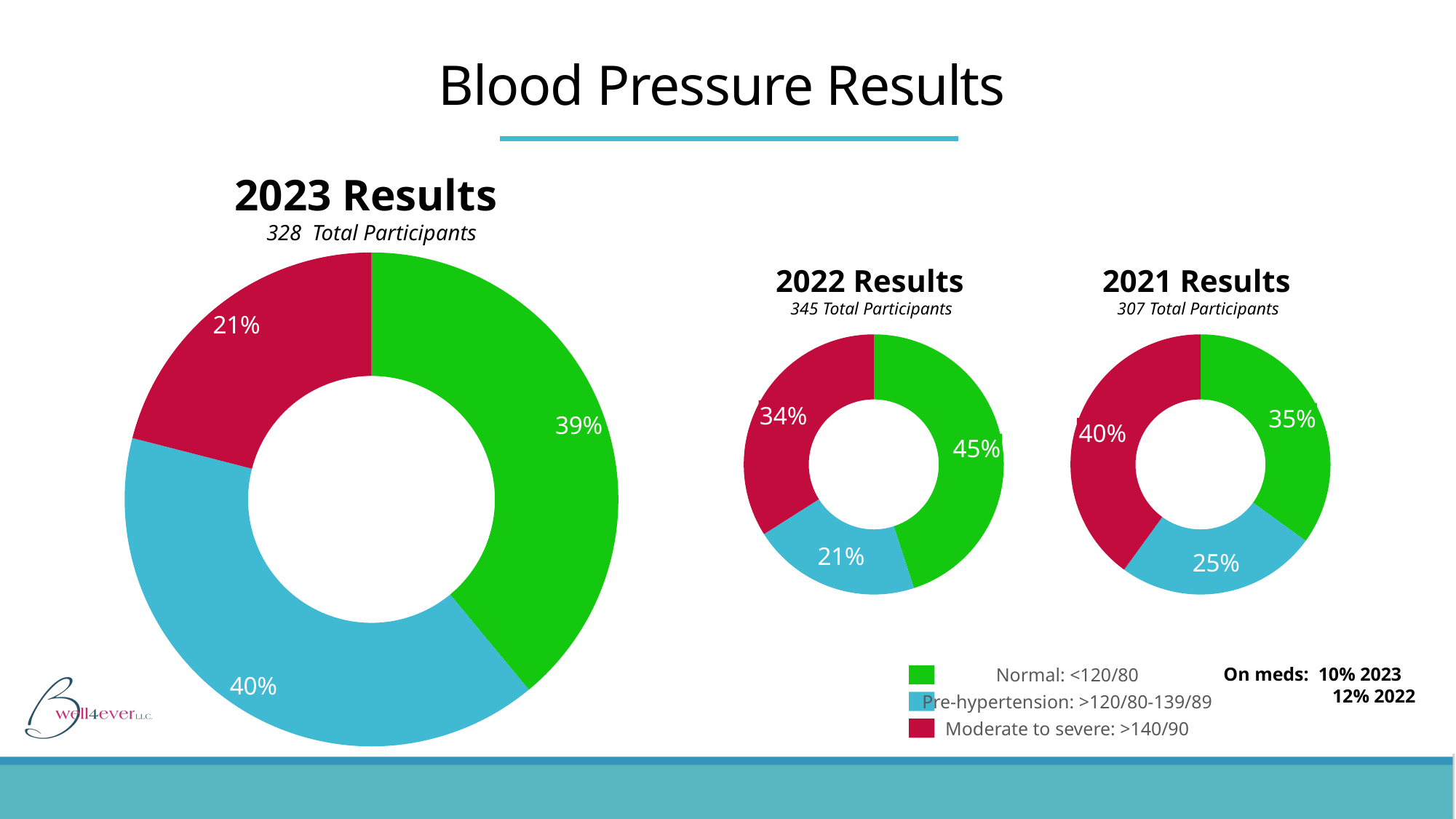
How many total participants are listed for the 2022 Results chart? 345 In the 2021 Results chart, which category has the smallest share? Pre-hypertension How many categories does each donut chart on the slide show? 3 In the 2022 Results chart, which category has the largest share? Normal In the 2023 Results chart, what percentage of participants were in the Pre-hypertension category? 40% In the 2022 Results chart, what is the difference in percentage points between the Normal and Pre-hypertension shares? 24 In the 2023 Results chart, which category has the smallest share? Moderate to severe In the 2023 Results chart, what percentage of participants were in the Normal category? 39% In the 2021 Results chart, what percentage of participants were in the Pre-hypertension category? 25% What type of chart is used for the 2023 Results? Donut chart In the 2022 Results chart, what percentage of participants were in the Moderate to severe category? 34% In the 2021 Results chart, which is larger: the Moderate to severe share or the Normal share? Moderate to severe